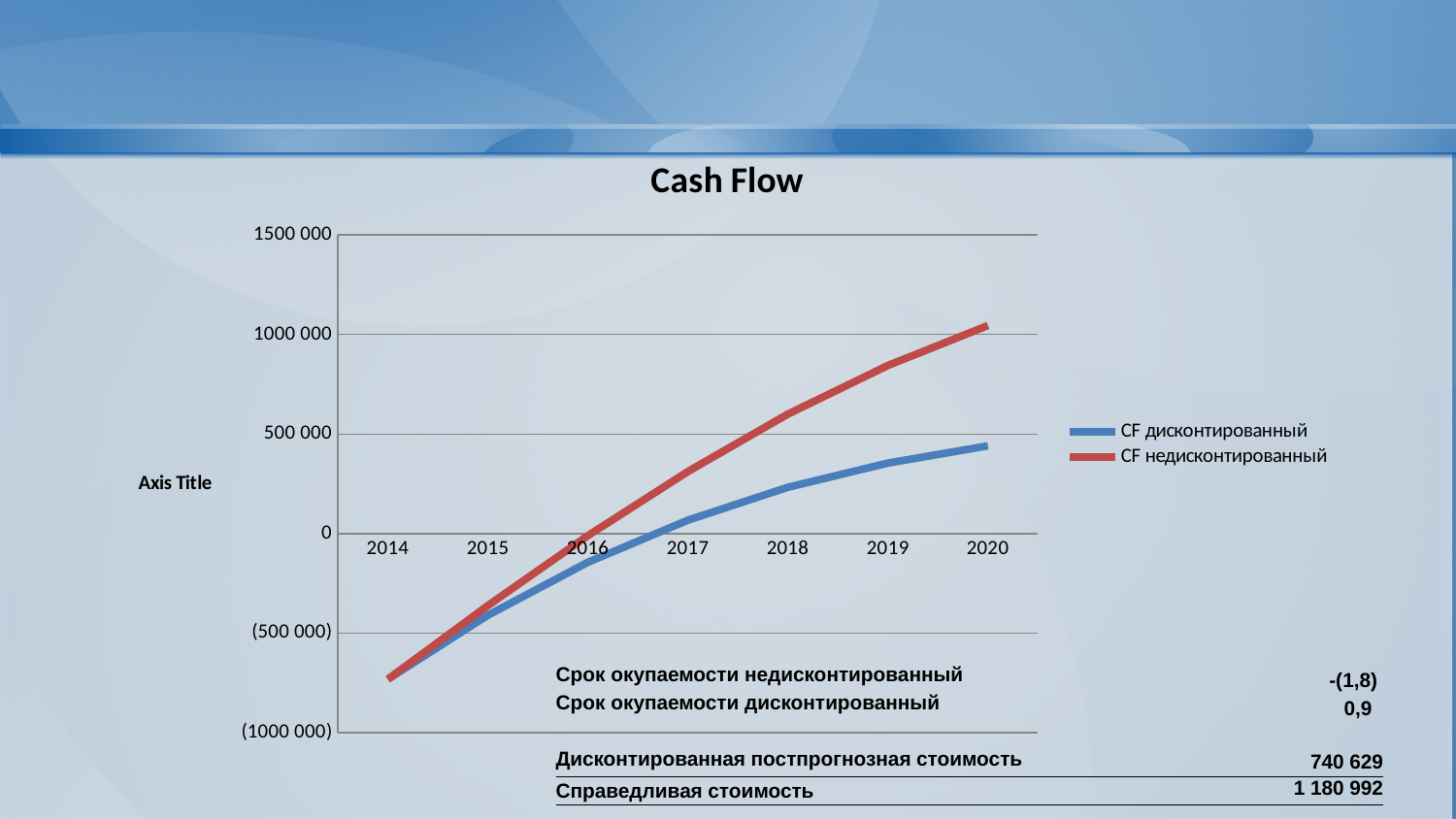
Do the values of the CF недисконтированный series rise or fall from 2014 to 2020? rise How many series does the legend list? 2 Is the value for CF дисконтированный in 2018 greater or less than 500 000? less Which series is drawn in red in the chart? CF недисконтированный In which year does the CF недисконтированный series reach its highest value? 2020 What kind of chart is shown on the slide? line chart Is the value for CF недисконтированный in 2020 greater or less than 500 000? greater What is the title of the chart? Cash Flow Do the values of the CF дисконтированный series rise or fall from 2014 to 2020? rise How many years are shown on the x axis of the chart? 7 In 2020, which series has the higher value, CF дисконтированный or CF недисконтированный? CF недисконтированный Is the value for CF дисконтированный in 2020 greater or less than 500 000? less